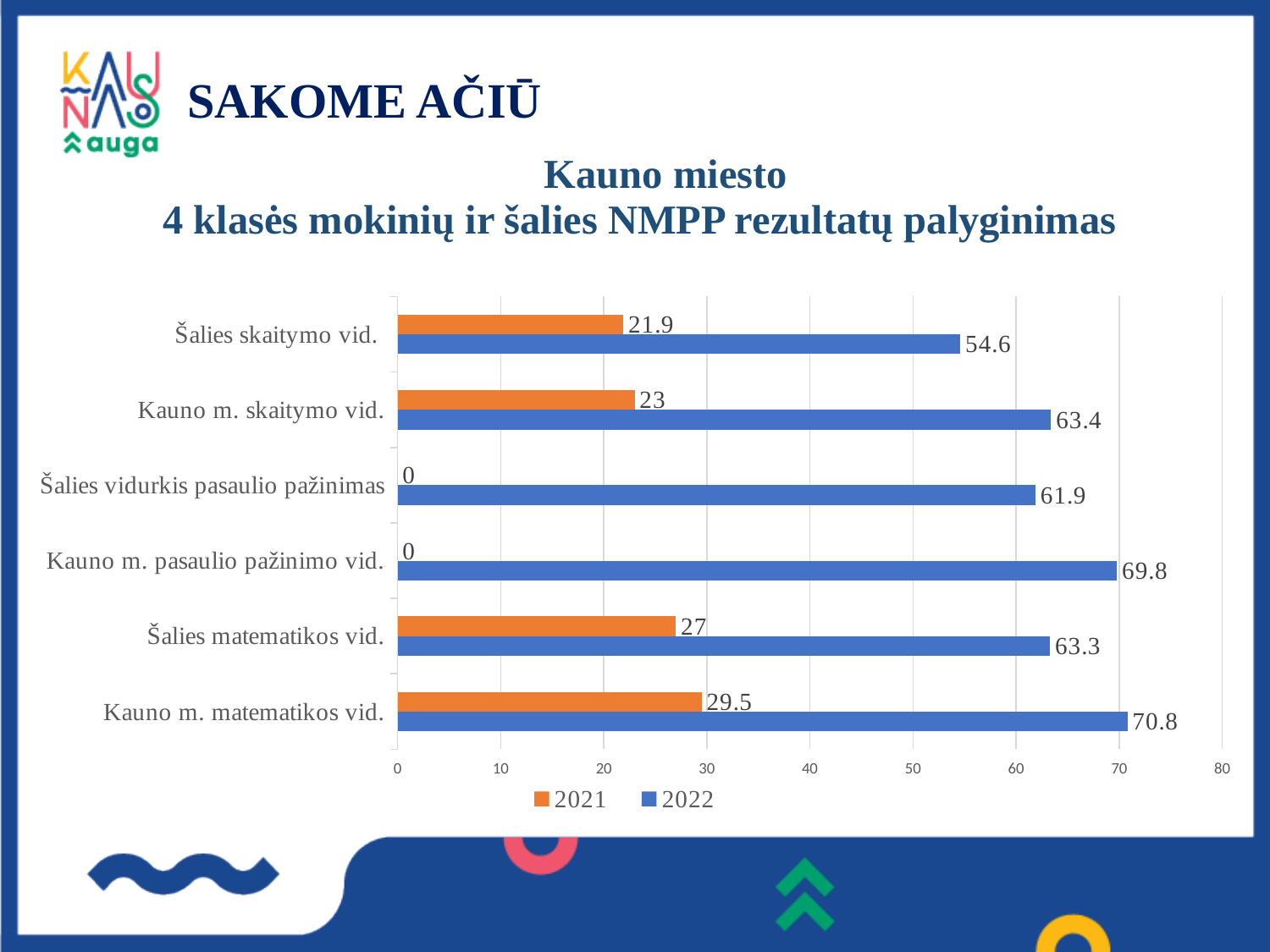
Is the 2022 value for Kauno m. pasaulio pažinimo vid. greater or less than 60? greater How many categories are shown on the chart? 6 How many series does the legend list? 2 What is the 2021 value for Šalies skaitymo vid.? 21.9 Which is larger, the 2021 value for Kauno m. matematikos vid. or the 2021 value for Šalies matematikos vid.? Kauno m. matematikos vid. Which category has the highest 2022 value? Kauno m. matematikos vid. What is the 2022 value for Šalies vidurkis pasaulio pažinimas? 61.9 What kind of chart is shown on the slide? bar chart What is the difference between the 2022 values for Kauno m. skaitymo vid. and Šalies skaitymo vid.? 8.8 Which colour represents the 2021 series? orange What is the 2022 value for Kauno m. matematikos vid.? 70.8 Which category has the lowest 2022 value? Šalies skaitymo vid.